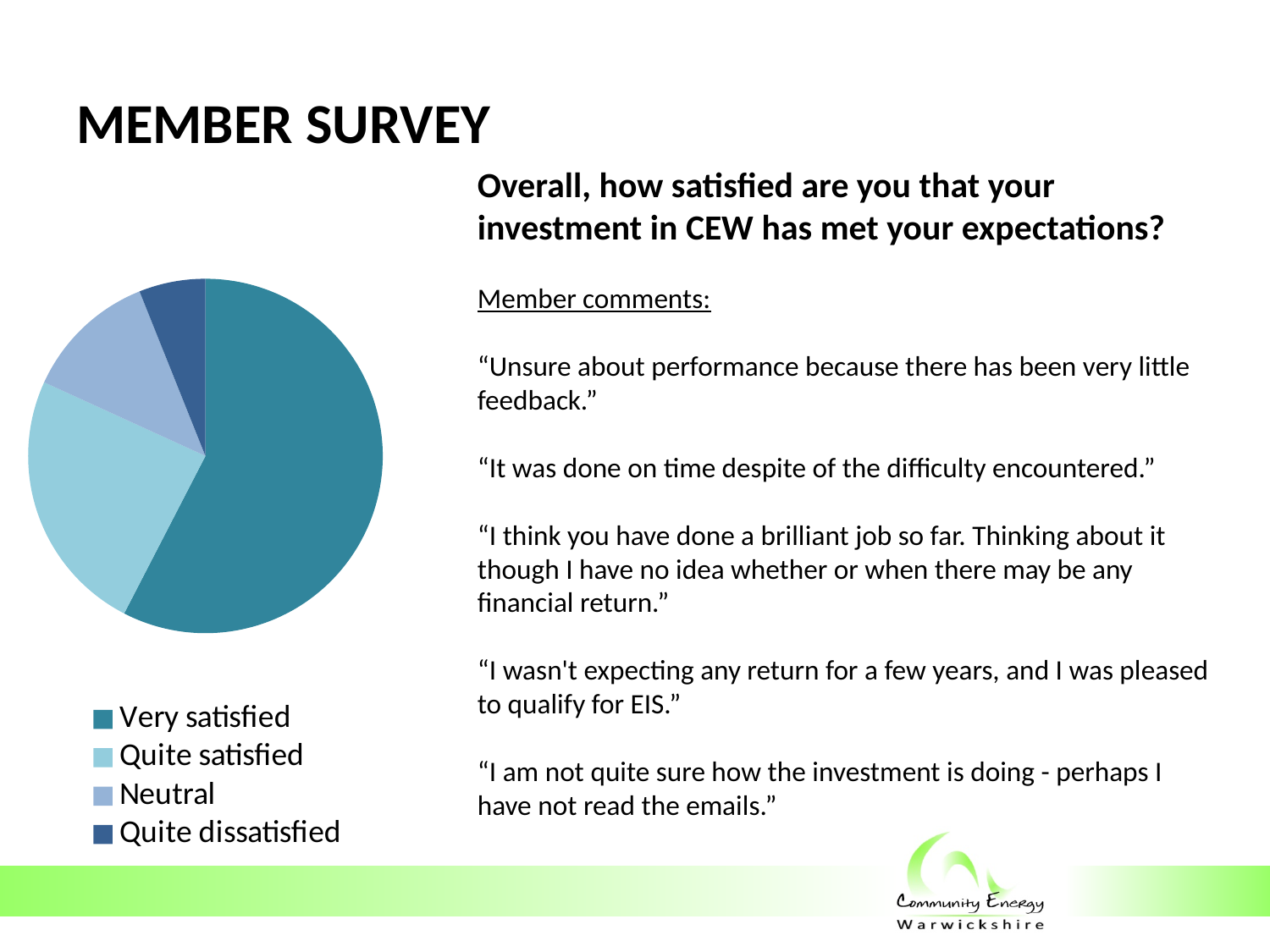
What kind of chart is shown on the slide? Pie chart Which survey question does the pie chart present responses to? Overall, how satisfied are you that your investment in CEW has met your expectations? Which category has the smallest slice of the pie chart? Quite dissatisfied How many categories does the pie chart show? 4 Which slice is larger, Very satisfied or Quite satisfied? Very satisfied Which slice is larger, Quite satisfied or Neutral? Quite satisfied Is the Very satisfied slice more or less than half of the pie? more Which slice is larger, Neutral or Quite dissatisfied? Neutral Which category is listed first in the legend of the pie chart? Very satisfied Which category has the largest slice of the pie chart? Very satisfied